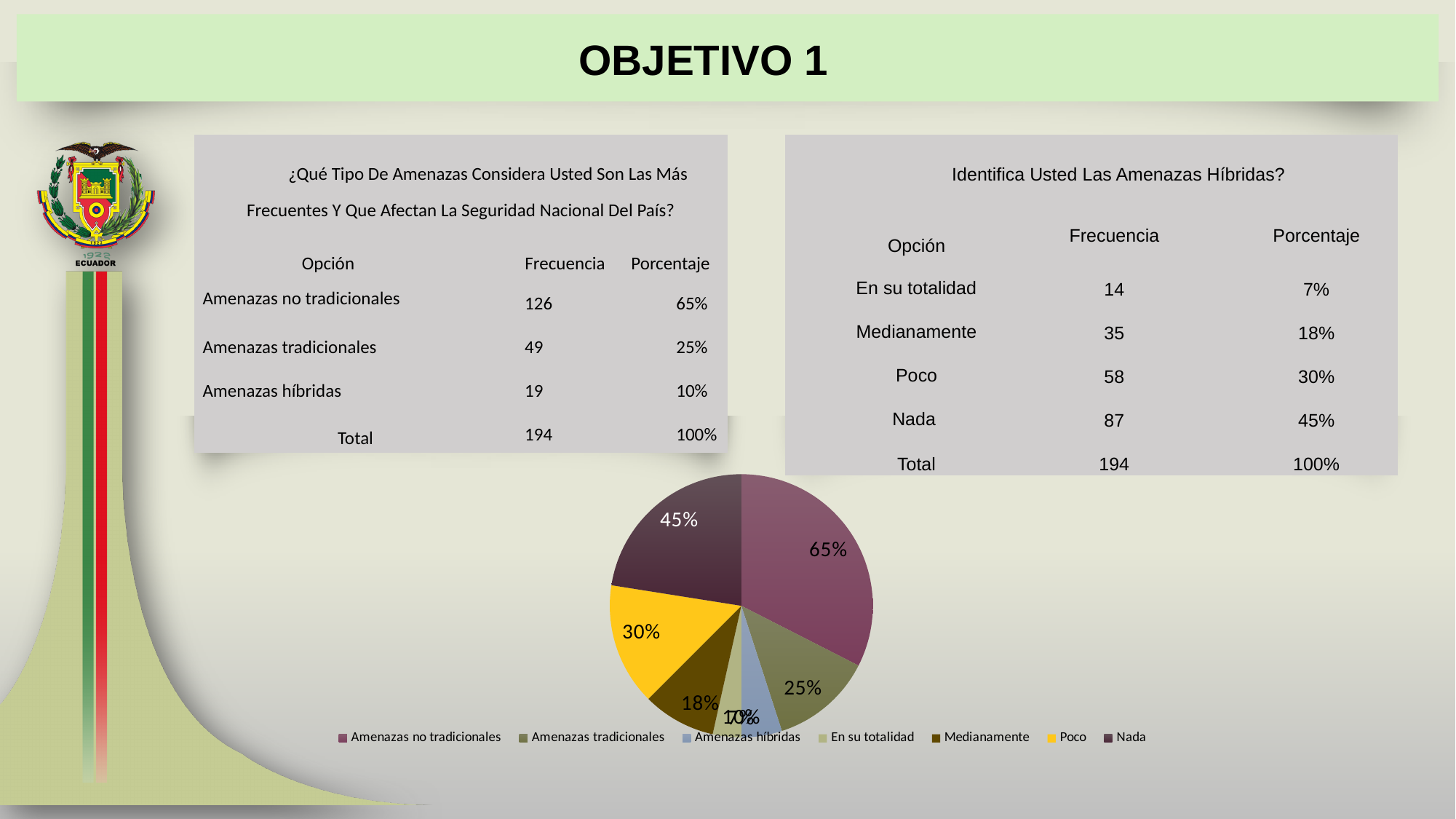
What percentage is shown for the Amenazas tradicionales slice of the pie chart? 25% What percentage is shown for the Medianamente slice of the pie chart? 18% What is the difference between the Amenazas no tradicionales slice and the Amenazas tradicionales slice in the pie chart? 40% What percentage is shown for the Amenazas no tradicionales slice of the pie chart? 65% What colour is the Poco slice in the pie chart? yellow What percentage is shown for the Nada slice of the pie chart? 45% Which slice is larger in the pie chart, Nada or Poco? Nada How many entries does the legend of the pie chart list? 7 What kind of chart is shown on the slide? pie chart Which slice is larger in the pie chart, Medianamente or Amenazas tradicionales? Amenazas tradicionales What percentage is shown for the Poco slice of the pie chart? 30% Which slice of the pie chart has the largest percentage? Amenazas no tradicionales